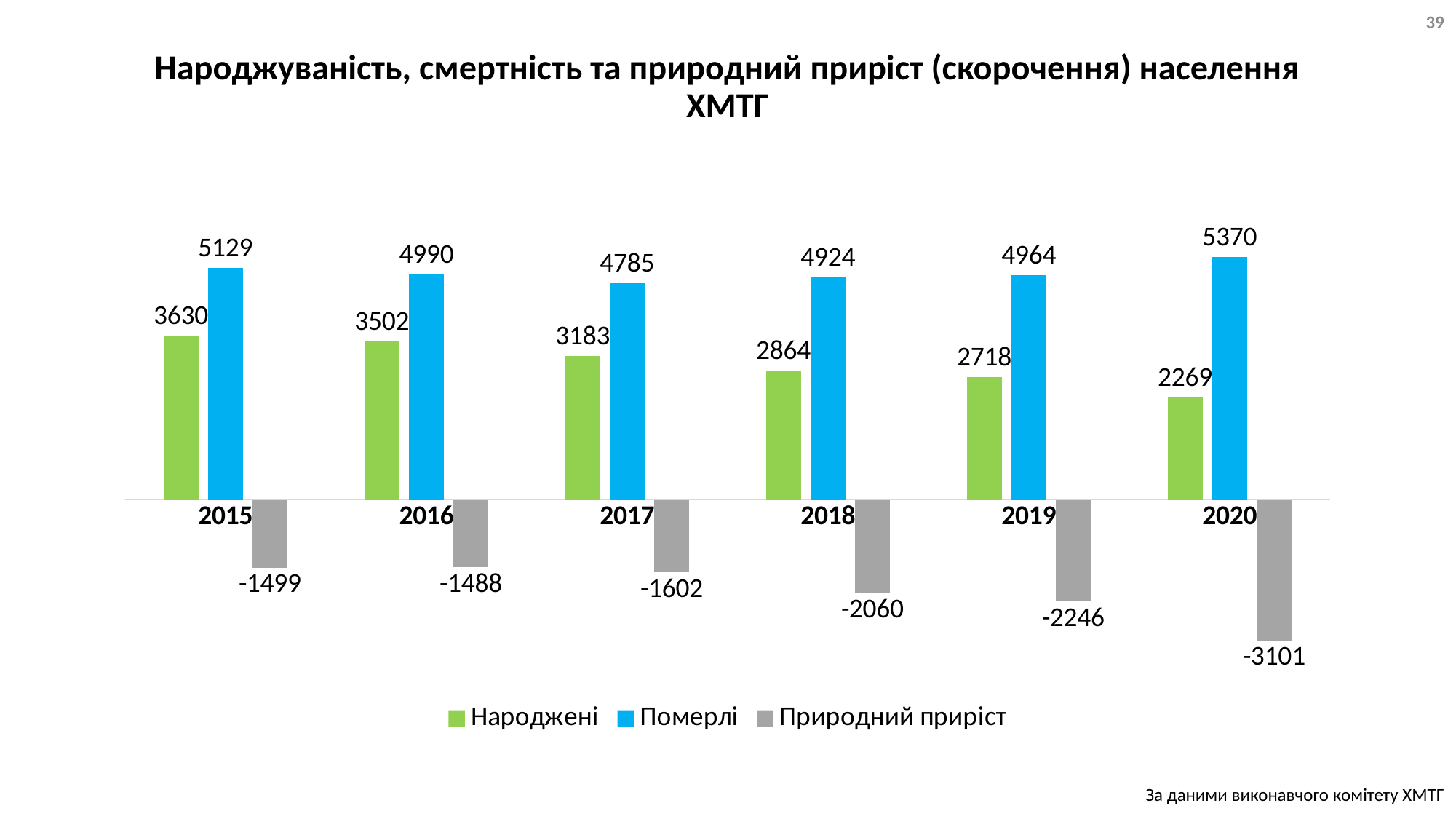
In which year is the Народжені value lowest? 2020 Do the Народжені values rise or fall from 2015 to 2020? fall How many series does the legend list? 3 In which year is the Померлі value highest? 2020 What is the value for Померлі in 2020? 5370 How many years are shown on the x axis? 6 What is the value for Народжені in 2015? 3630 Which is larger in 2019: Народжені or Померлі? Померлі Which colour represents Природний приріст in the legend? grey What is the difference between Померлі and Народжені in 2017? 1602 What is the value for Природний приріст in 2018? -2060 What kind of chart is shown on the slide? bar chart